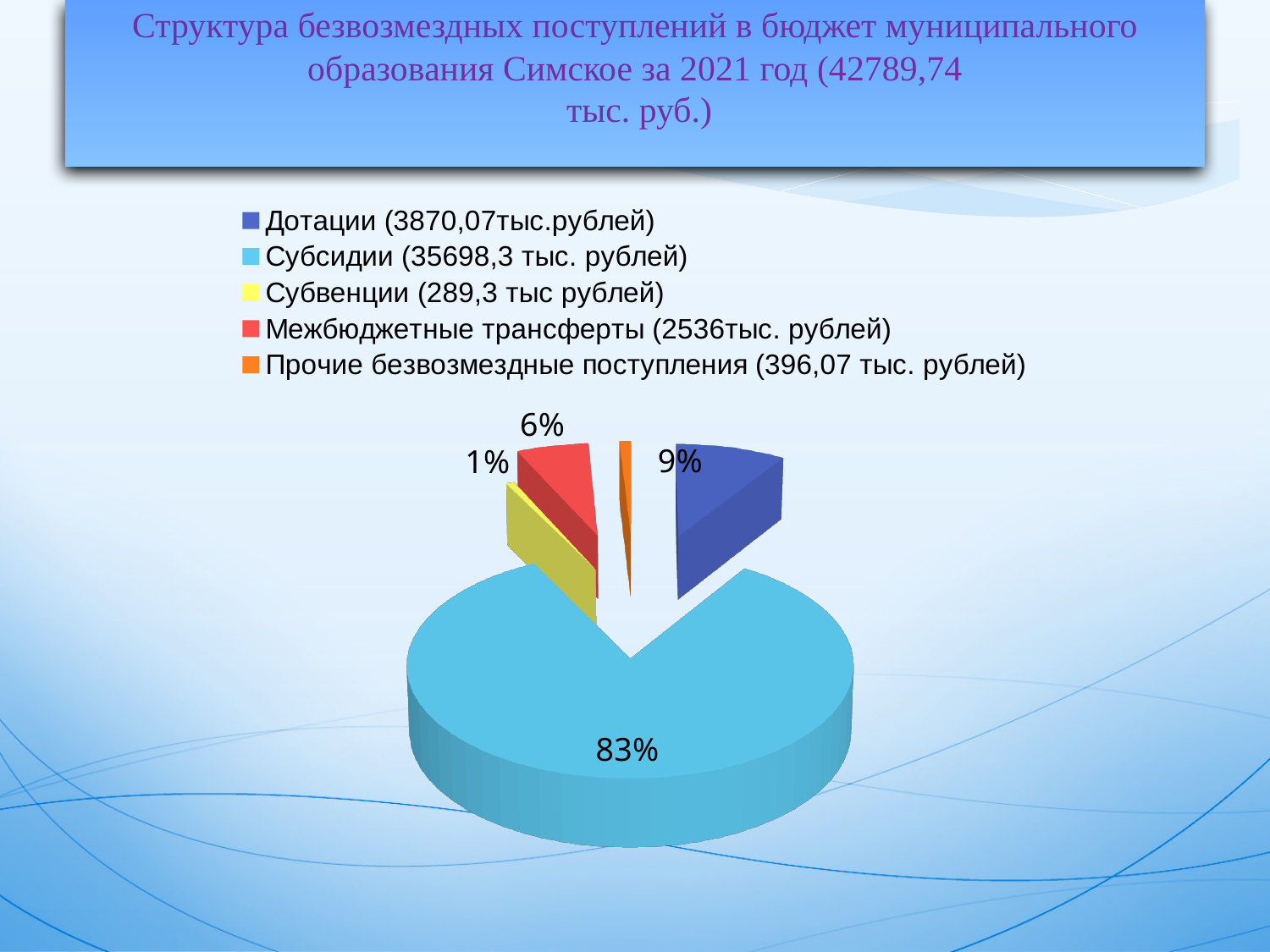
What share of the pie does Межбюджетные трансферты take? 6% What share of the pie does Субвенции take? 1% How many slices does the pie chart have? 5 What kind of chart is shown on the slide? Pie chart How many entries does the legend list? 5 What value in тыс. рублей does the legend give for Дотации? 3870,07 Which category has the smallest value according to the legend? Субвенции What share of the pie does Дотации take? 9% Which category has the largest share of the pie? Субсидии Which has the larger share: Дотации or Межбюджетные трансферты? Дотации What is the difference in percentage points between the Субсидии share and the Дотации share? 74%